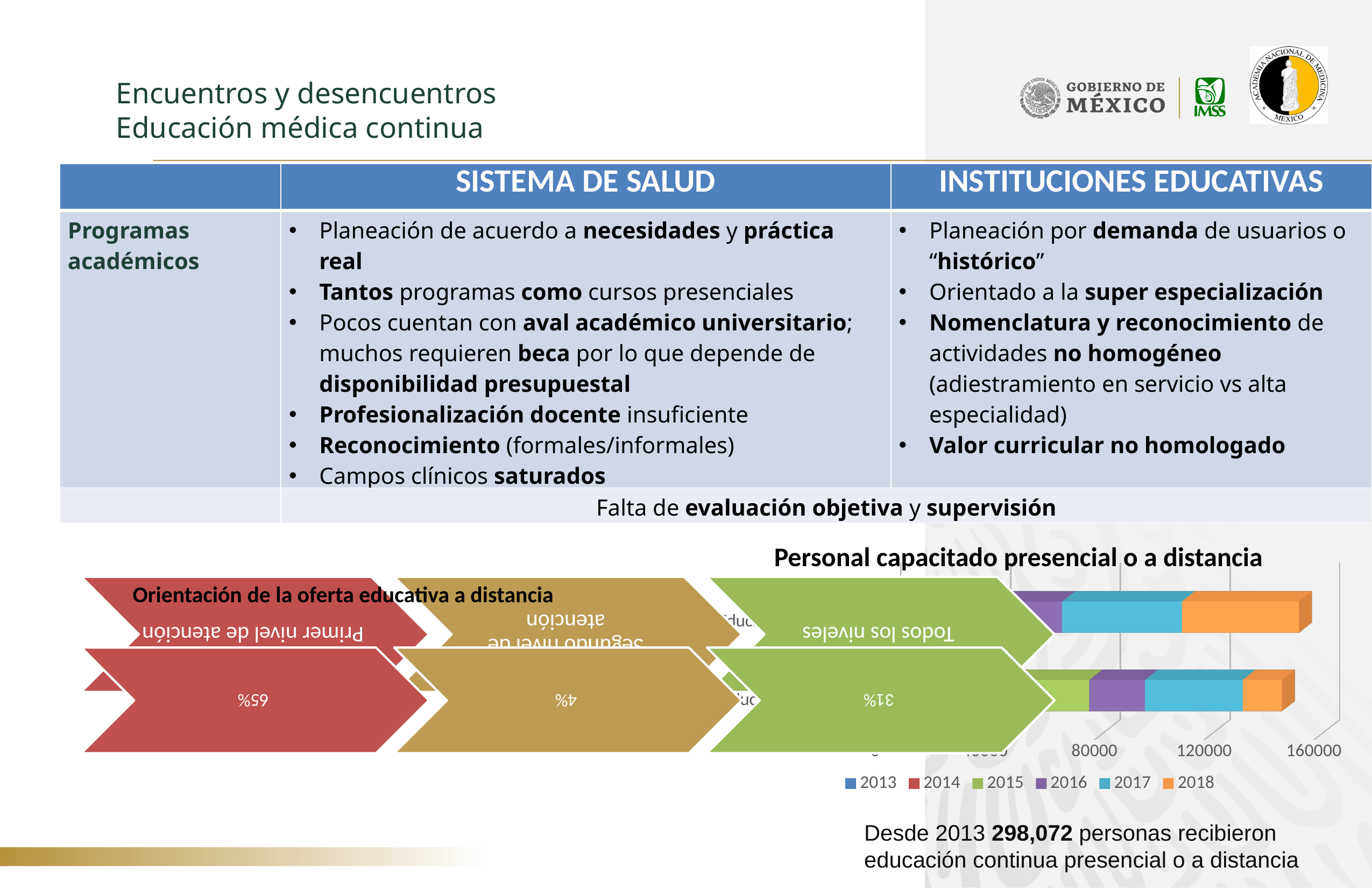
In the 'Personal capacitado presencial o a distancia' chart, is the total of the bottom stacked bar greater or less than 160000? less In the 'Personal capacitado presencial o a distancia' chart, is the total of the bottom stacked bar greater or less than 80000? greater In the 'Personal capacitado presencial o a distancia' chart, is the total of the top stacked bar greater or less than 120000? greater How many stacked bars are visible in the 'Personal capacitado presencial o a distancia' chart? 2 Which years are listed in the legend of the 'Personal capacitado presencial o a distancia' chart? 2013, 2014, 2015, 2016, 2017, 2018 What is the highest value shown on the horizontal axis of the 'Personal capacitado presencial o a distancia' chart? 160000 What kind of chart is 'Personal capacitado presencial o a distancia'? bar chart What is the title of the chart on the right side of the slide? Personal capacitado presencial o a distancia How many series does the legend of the 'Personal capacitado presencial o a distancia' chart list? 6